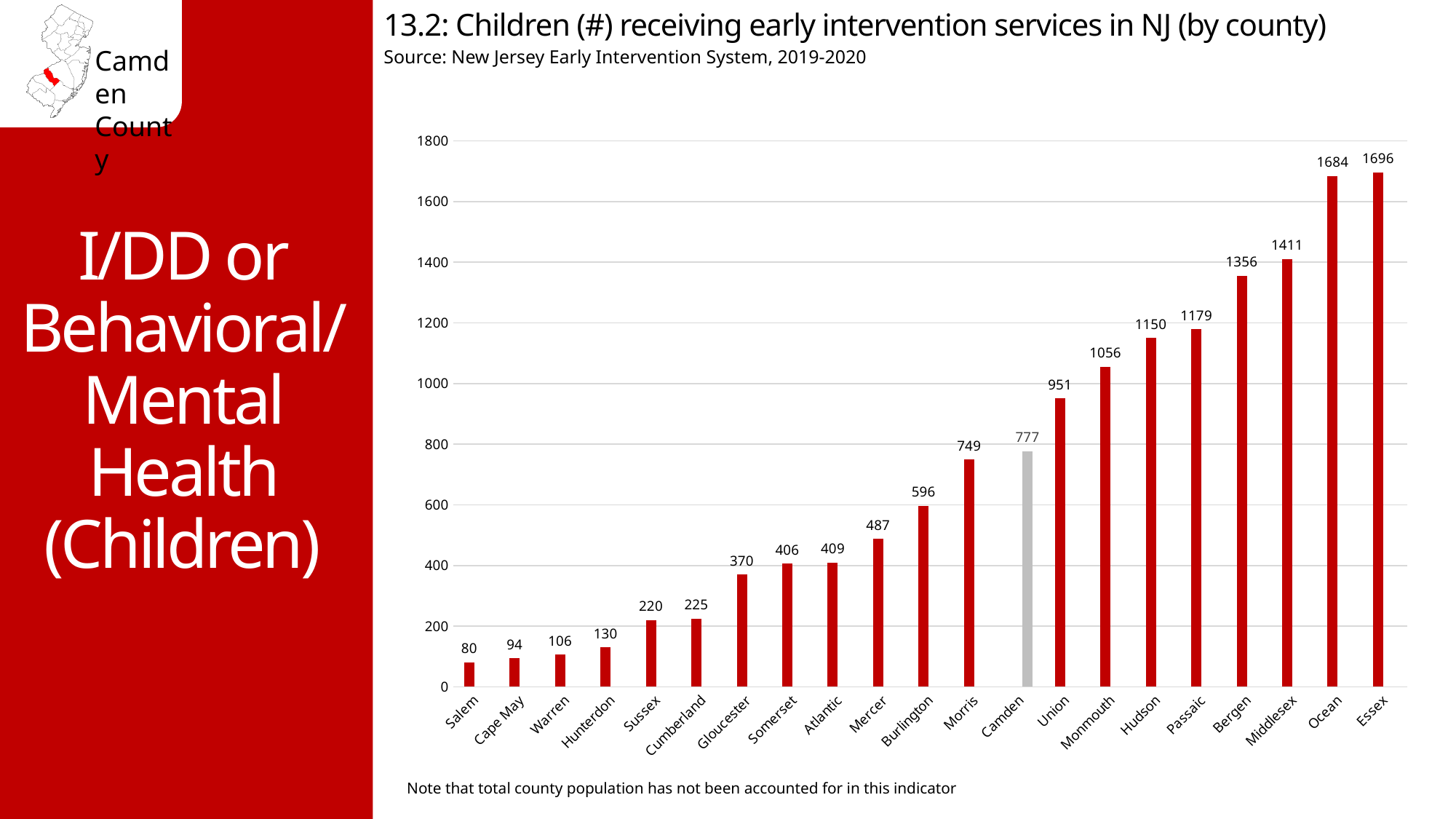
Which county has the lowest number of children receiving early intervention services? Salem Which county's bar is shown in gray instead of red? Camden What is the difference between the values for Camden and Union? 174 Which county has the highest number of children receiving early intervention services? Essex Do the values rise or fall moving from left to right along the x axis? rise What kind of chart is shown on the slide? bar chart What is the value shown for Bergen County? 1356 Is the value for Morris greater or less than 800? less How many counties are shown on the chart? 21 What is the difference between the values for Essex and Ocean? 12 How many children in Camden County are receiving early intervention services? 777 Which county has a larger value, Hudson or Passaic? Passaic